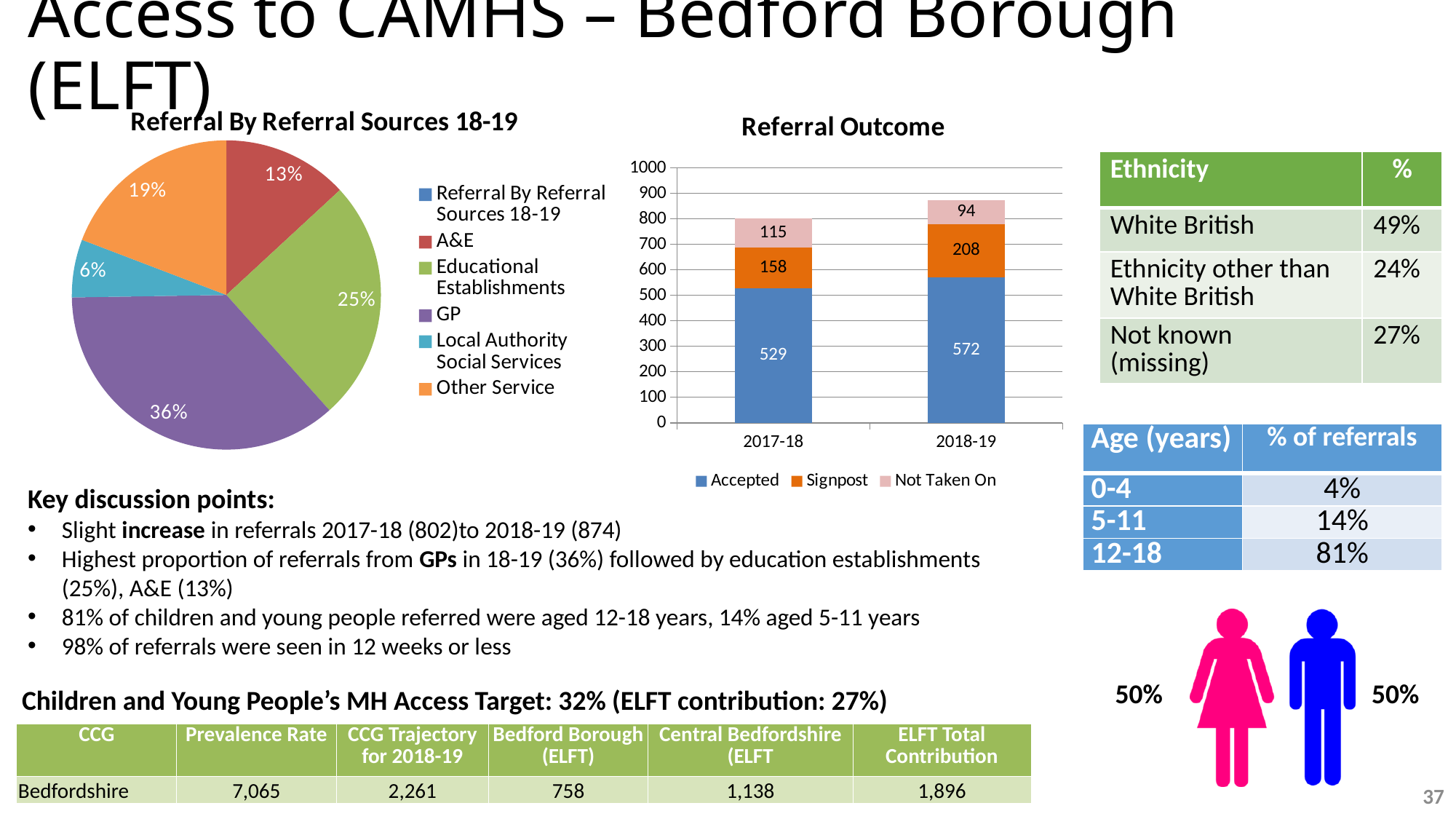
In the Referral Outcome chart, how many referrals were Accepted in 2018-19? 572 In the Referral Outcome chart, what is the total height of the 2018-19 stacked bar? 874 How many series does the legend of the Referral Outcome chart list? 3 In the Referral By Referral Sources 18-19 pie chart, which referral source has the smallest slice? Local Authority Social Services In the Referral By Referral Sources 18-19 pie chart, what share of referrals came from Educational Establishments? 25% In the Referral By Referral Sources 18-19 pie chart, what share of referrals came from GPs? 36% In the Referral Outcome chart, how many referrals were Not Taken On in 2017-18? 115 In the Referral By Referral Sources 18-19 pie chart, how many percentage points larger is the Other Service slice than the A&E slice? 6 What kind of chart is the Referral Outcome chart? Stacked bar chart In the Referral Outcome chart, what is the difference in Signpost referrals between 2018-19 and 2017-18? 50 What kind of chart is the Referral By Referral Sources 18-19 chart? Pie chart In the Referral By Referral Sources 18-19 pie chart, which referral source has the largest slice? GP